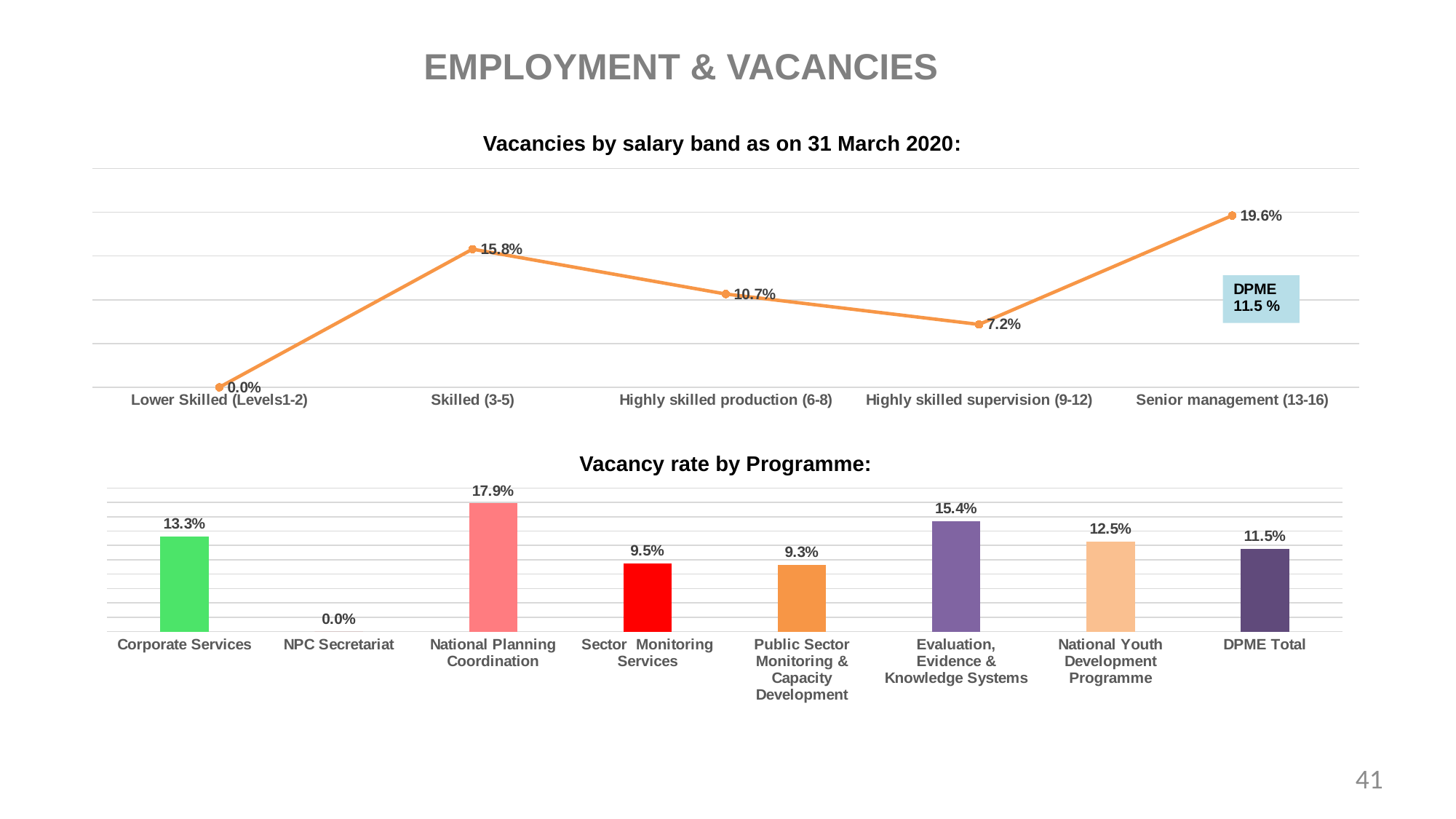
In the 'Vacancy rate by Programme' chart, what is the difference between National Planning Coordination and Corporate Services? 4.6% What kind of chart is 'Vacancy rate by Programme'? Bar chart How many salary bands are plotted in the 'Vacancies by salary band as on 31 March 2020' chart? 5 In the 'Vacancies by salary band as on 31 March 2020' chart, which salary band has the highest vacancy rate? Senior management (13-16) In the 'Vacancy rate by Programme' chart, what is the vacancy rate for Evaluation, Evidence & Knowledge Systems? 15.4% In the 'Vacancy rate by Programme' chart, which programme has the highest vacancy rate? National Planning Coordination In the 'Vacancies by salary band as on 31 March 2020' chart, what is the value for Highly skilled supervision (9-12)? 7.2% How many programmes (bars) are shown in the 'Vacancy rate by Programme' chart? 8 In the 'Vacancies by salary band as on 31 March 2020' chart, what is the difference between Senior management (13-16) and Highly skilled production (6-8)? 8.9% What kind of chart is 'Vacancies by salary band as on 31 March 2020'? Line chart In the 'Vacancies by salary band as on 31 March 2020' chart, what is the value for Skilled (3-5)? 15.8% In the 'Vacancy rate by Programme' chart, which is larger: Sector Monitoring Services or Public Sector Monitoring & Capacity Development? Sector Monitoring Services